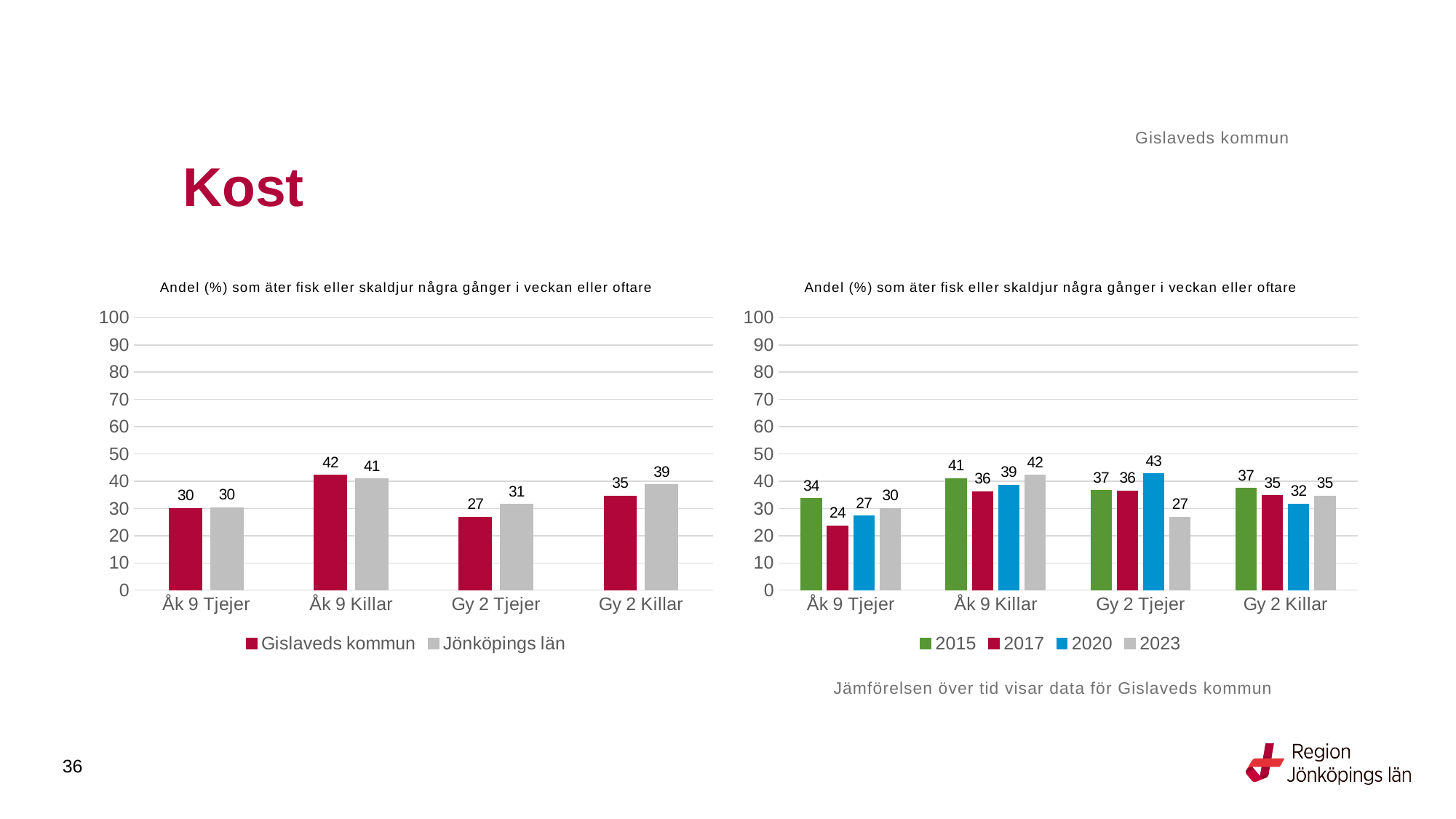
In the left chart, how many series does the legend list? 2 In the right chart, what is the value for 2020 for Gy 2 Tjejer? 43 In the left chart, which category has the lowest value for Gislaveds kommun? Gy 2 Tjejer In the right chart, what is the difference between the 2020 and 2023 values for Gy 2 Tjejer? 16 In the right chart, what is the value for 2017 for Åk 9 Tjejer? 24 In the left chart, what is the value for Jönköpings län for Gy 2 Tjejer? 31 In the right chart, how many series does the legend list? 4 In the left chart, what is the difference between Jönköpings län and Gislaveds kommun for Gy 2 Killar? 4 What kind of chart is the right chart? Bar chart In the left chart, what is the value for Gislaveds kommun for Åk 9 Killar? 42 In the right chart, which year has the highest value for Åk 9 Killar? 2023 In the right chart, is the value for 2015 for Gy 2 Killar larger or smaller than the value for 2020 for Gy 2 Killar? larger